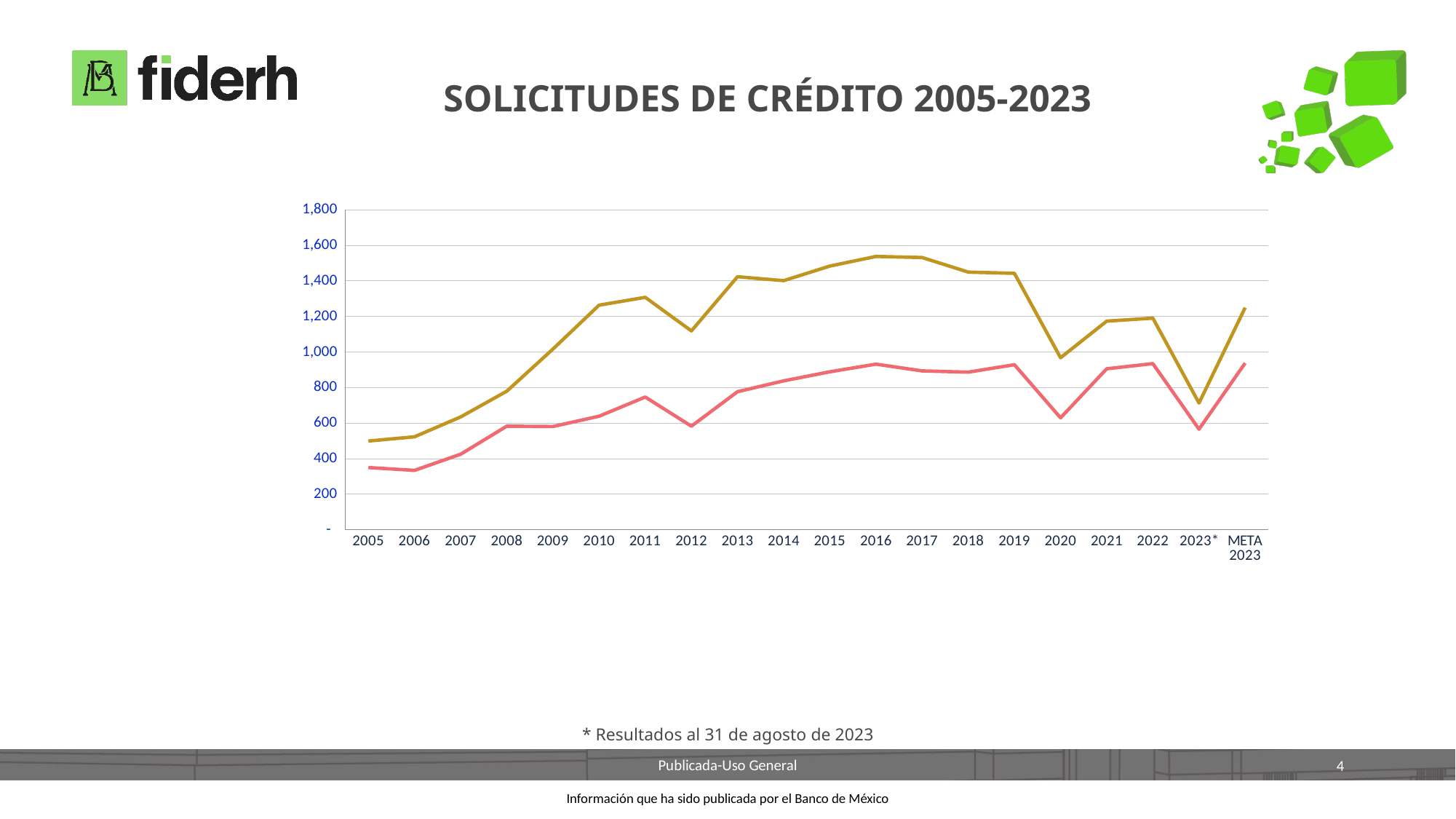
Is the value of the pink line for 2005 greater or less than 400? less What is the title of the slide's chart? SOLICITUDES DE CRÉDITO 2005-2023 What kind of chart is shown on the slide? line chart How many points are plotted along the x axis of the chart? 20 Is the value of the pink line for 2023* greater or less than 600? less For the gold line, which is larger, the value for 2011 or the value for 2012? 2011 Is the value of the gold line for 2023* greater or less than 800? less For the gold line, which is larger, the value for 2023* or the value for META 2023? META 2023 Does the gold line rise or fall from 2005 to 2010? rise Which line is higher across all years, the gold line or the pink line? the gold line